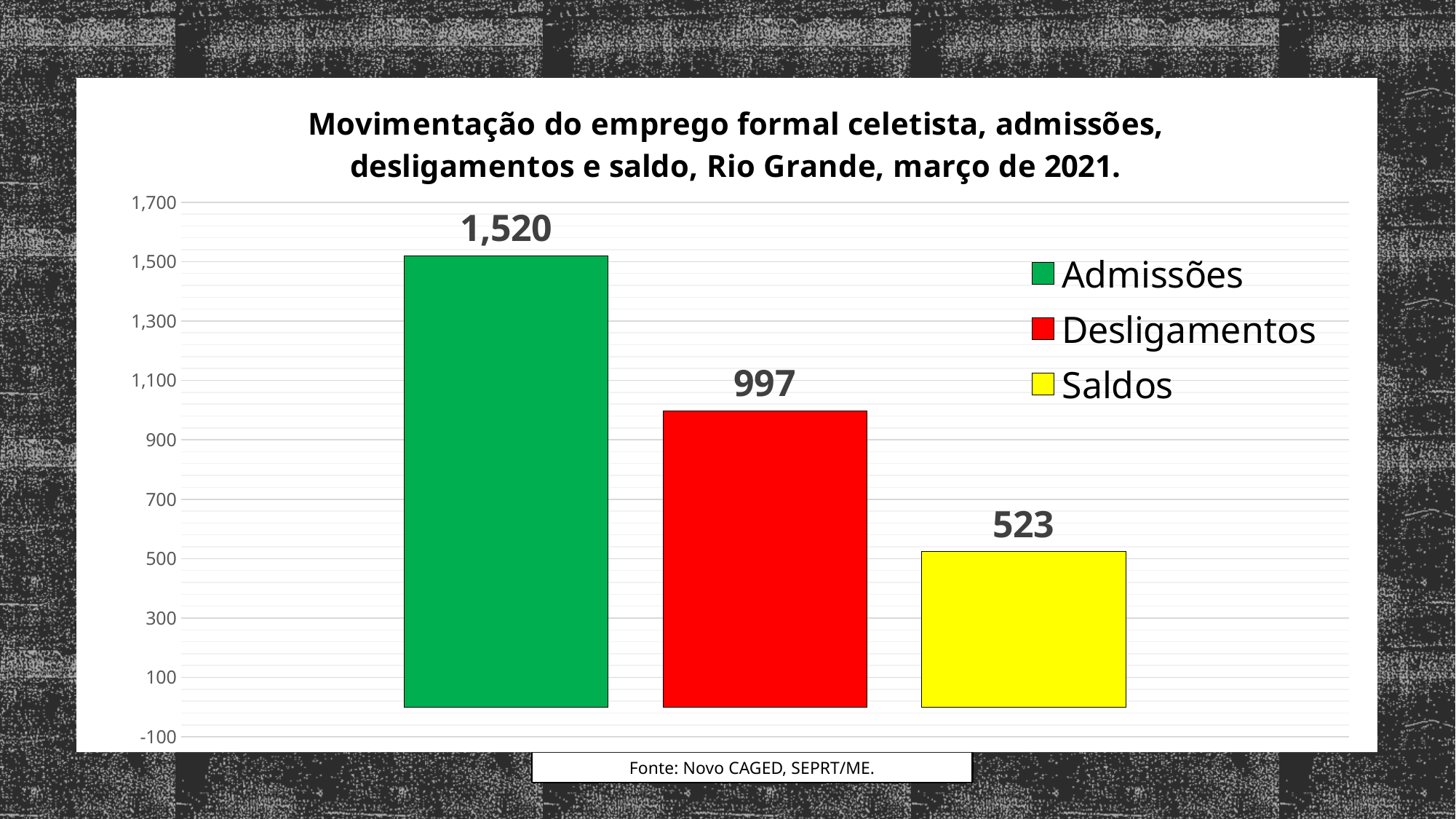
Which series has the highest value? Admissões What is the value for Admissões? 1,520 Which series has the lowest value? Saldos What is the value for Desligamentos? 997 What is the difference between Admissões and Desligamentos? 523 How many series does the legend list? 3 What kind of chart is shown on the slide? bar chart Which is larger, Desligamentos or Saldos? Desligamentos What is the value for Saldos? 523 What colour is the bar for Saldos? yellow Is the value for Desligamentos greater or less than 900? greater What is the difference between Desligamentos and Saldos? 474